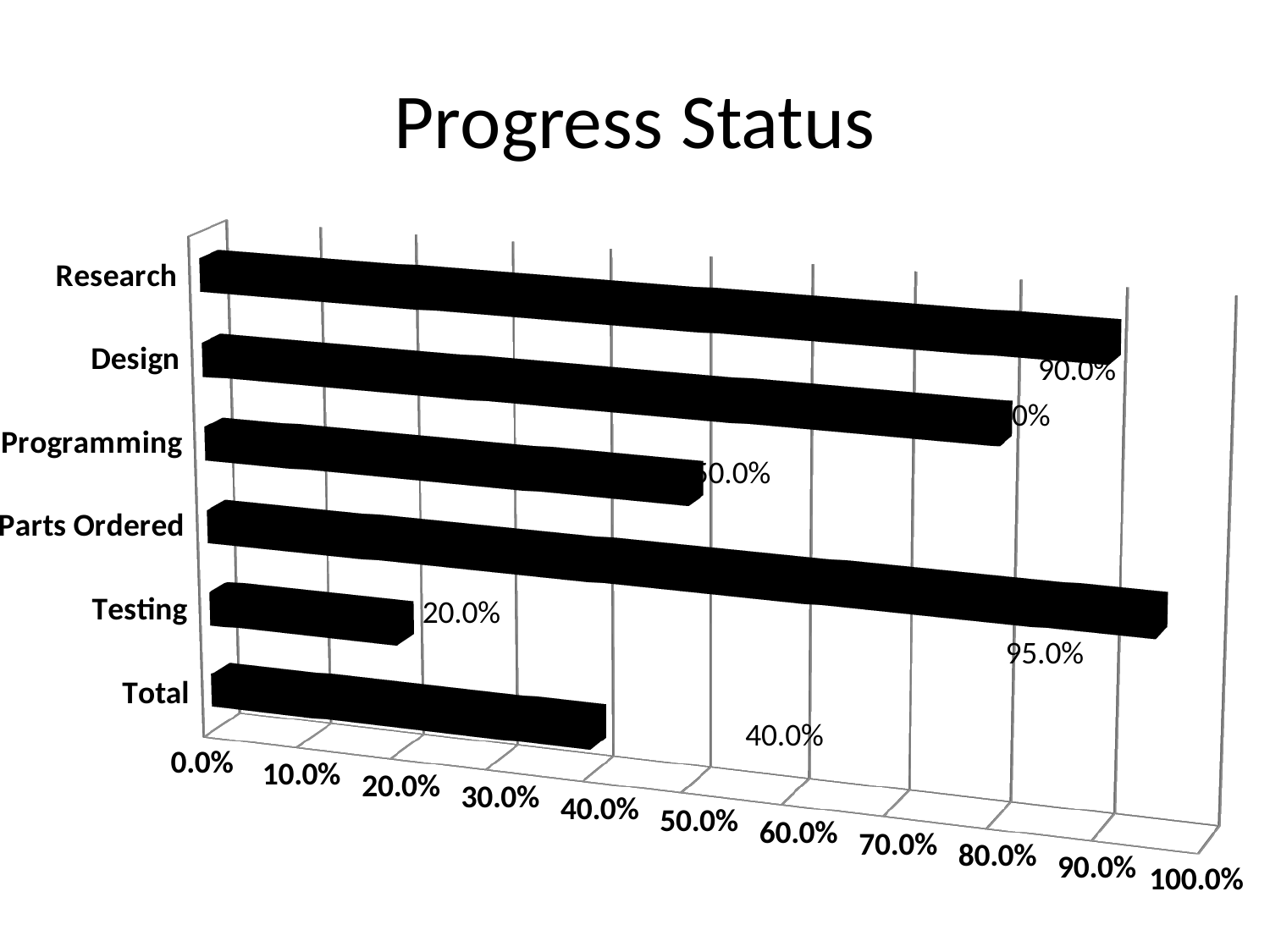
How many categories are shown in the chart? 6 What is the value for Research? 90.0% Which category has the lowest value? Testing What is the value for Parts Ordered? 95.0% What is the difference between the values for Research and Total? 50.0% Is the value for Design greater or less than 70.0%? greater What is the value for Testing? 20.0% What is the value for Total? 40.0% What kind of chart is shown on the slide? Bar chart Which is larger, the value for Research or the value for Parts Ordered? Parts Ordered Which category has the highest value? Parts Ordered What is the difference between the values for Parts Ordered and Testing? 75.0%